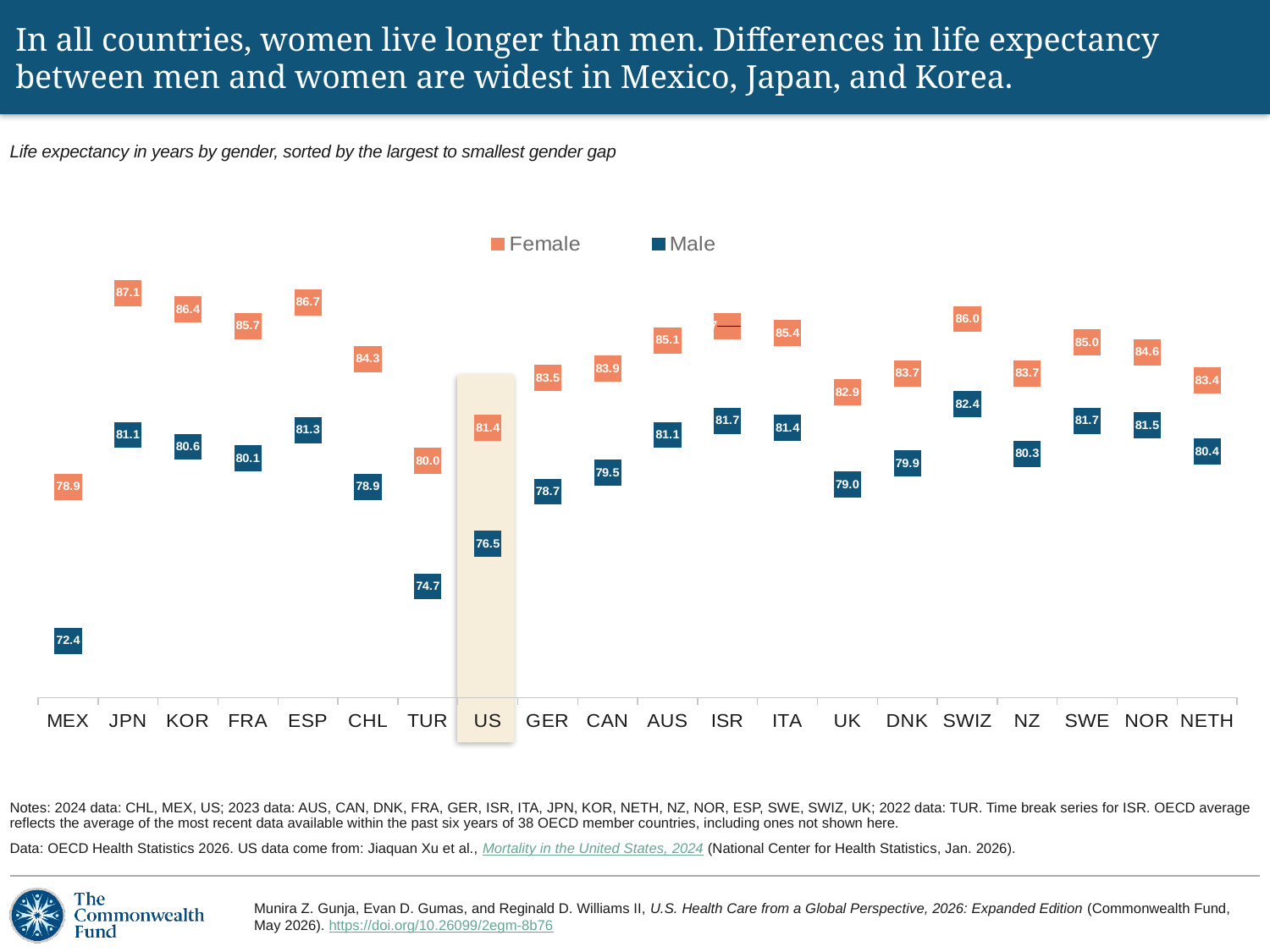
What is the female life expectancy for Japan (JPN)? 87.1 What is the difference between female and male life expectancy in the US? 4.9 Which country has the lowest male life expectancy? MEX What is the difference between female and male life expectancy in Mexico (MEX)? 6.5 Which is larger, the male life expectancy for Turkey (TUR) or for Germany (GER)? GER What is the male life expectancy for Mexico (MEX)? 72.4 How many series does the legend list? 2 Which country has the highest female life expectancy? JPN How many countries are shown on the x axis? 20 Which country has the highest male life expectancy? SWIZ What is the male life expectancy for the US? 76.5 What is the female life expectancy for Switzerland (SWIZ)? 86.0